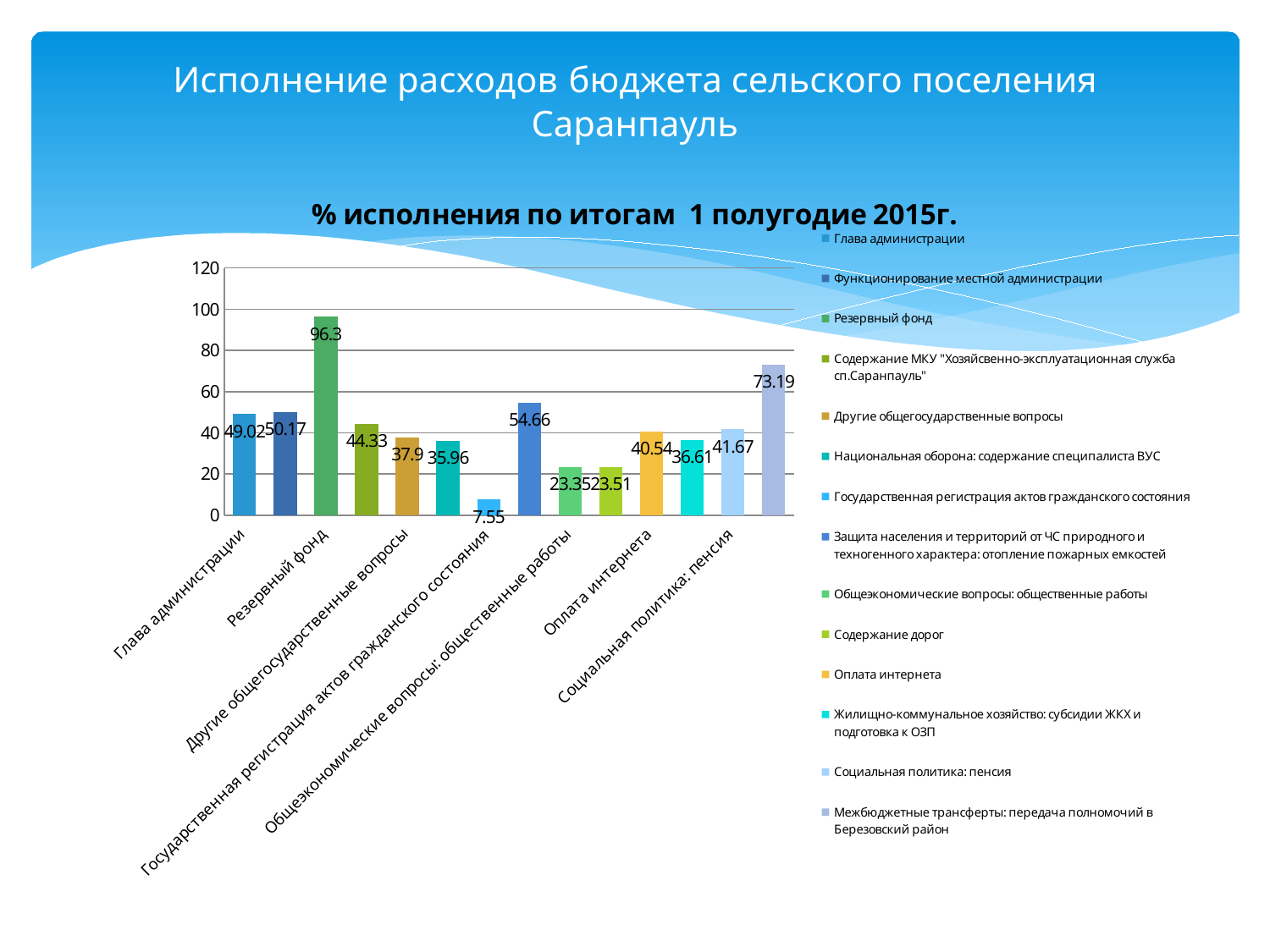
What is the difference between the values for Резервный фонд and Государственная регистрация актов гражданского состояния? 88.75 Which category has the lowest value? Государственная регистрация актов гражданского состояния What is the value for Резервный фонд? 96.3 Which is larger: the value for Глава администрации or the value for Функционирование местной администрации? Функционирование местной администрации How many bars are plotted in the chart? 14 What is the value for Государственная регистрация актов гражданского состояния? 7.55 What is the value for Оплата интернета? 40.54 How many entries does the legend list? 14 What is the title of the chart? % исполнения по итогам 1 полугодие 2015г. What kind of chart is shown? bar chart Is the value for Межбюджетные трансферты: передача полномочий в Березовский район greater or less than 60? greater Which category has the highest value? Резервный фонд